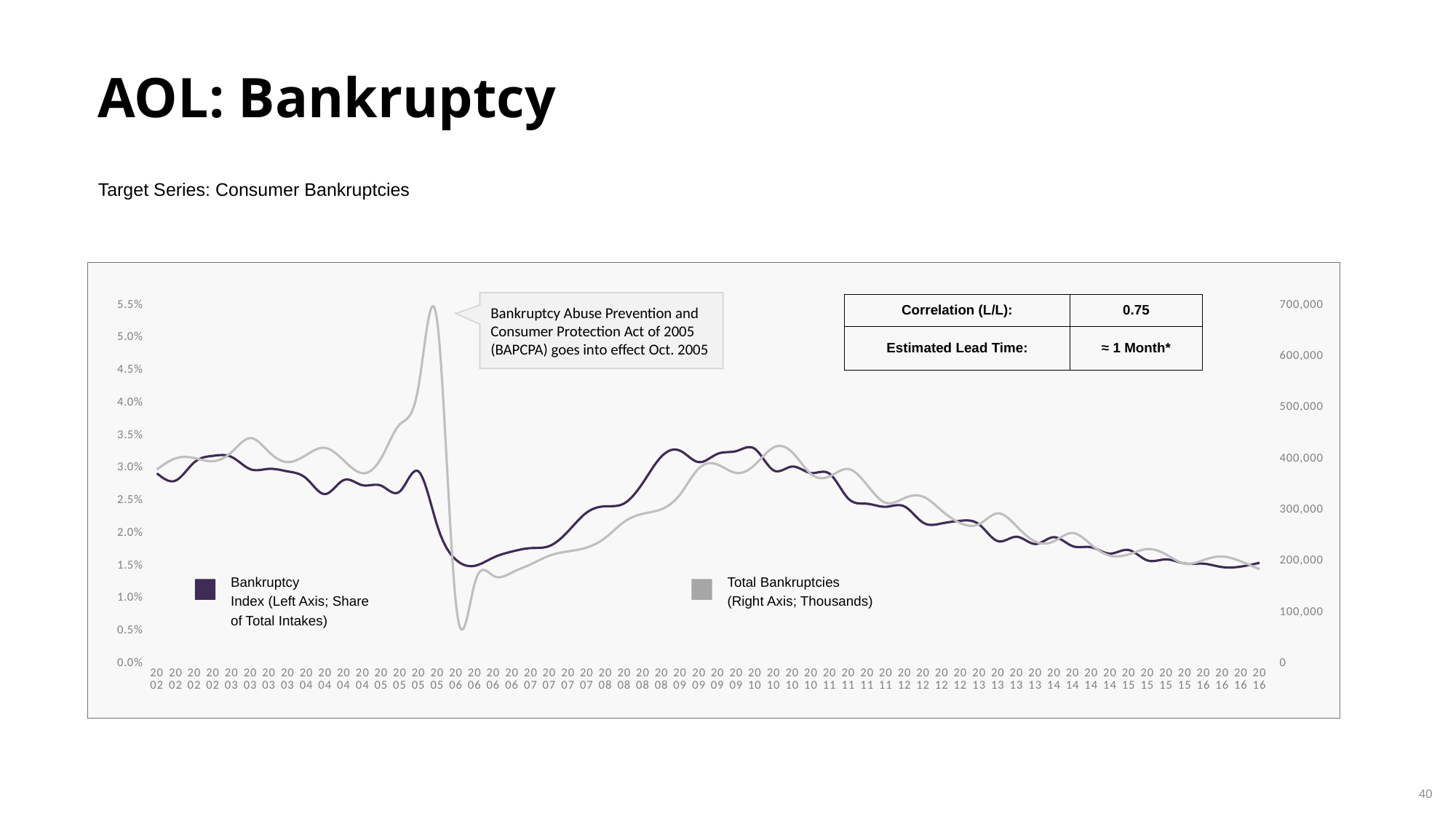
Is the value of the Bankruptcy Index at the end of 2016 greater or less than 2.0%? less What kind of chart is shown on the slide? Line chart Is the peak value of Total Bankruptcies in 2005 greater or less than 600,000? greater What correlation (L/L) value is shown in the table on the chart? 0.75 Which series is plotted on the right axis? Total Bankruptcies In which year does the Total Bankruptcies series reach its highest peak? 2005 In which year does the Total Bankruptcies series reach its lowest point? 2006 Does the Bankruptcy Index rise or fall between 2010 and 2016? fall Is the lowest value of the Bankruptcy Index in 2006 greater or less than 2.0%? less Does the Total Bankruptcies series rise or fall between 2006 and 2010? rise How many series does the chart's legend list? 2